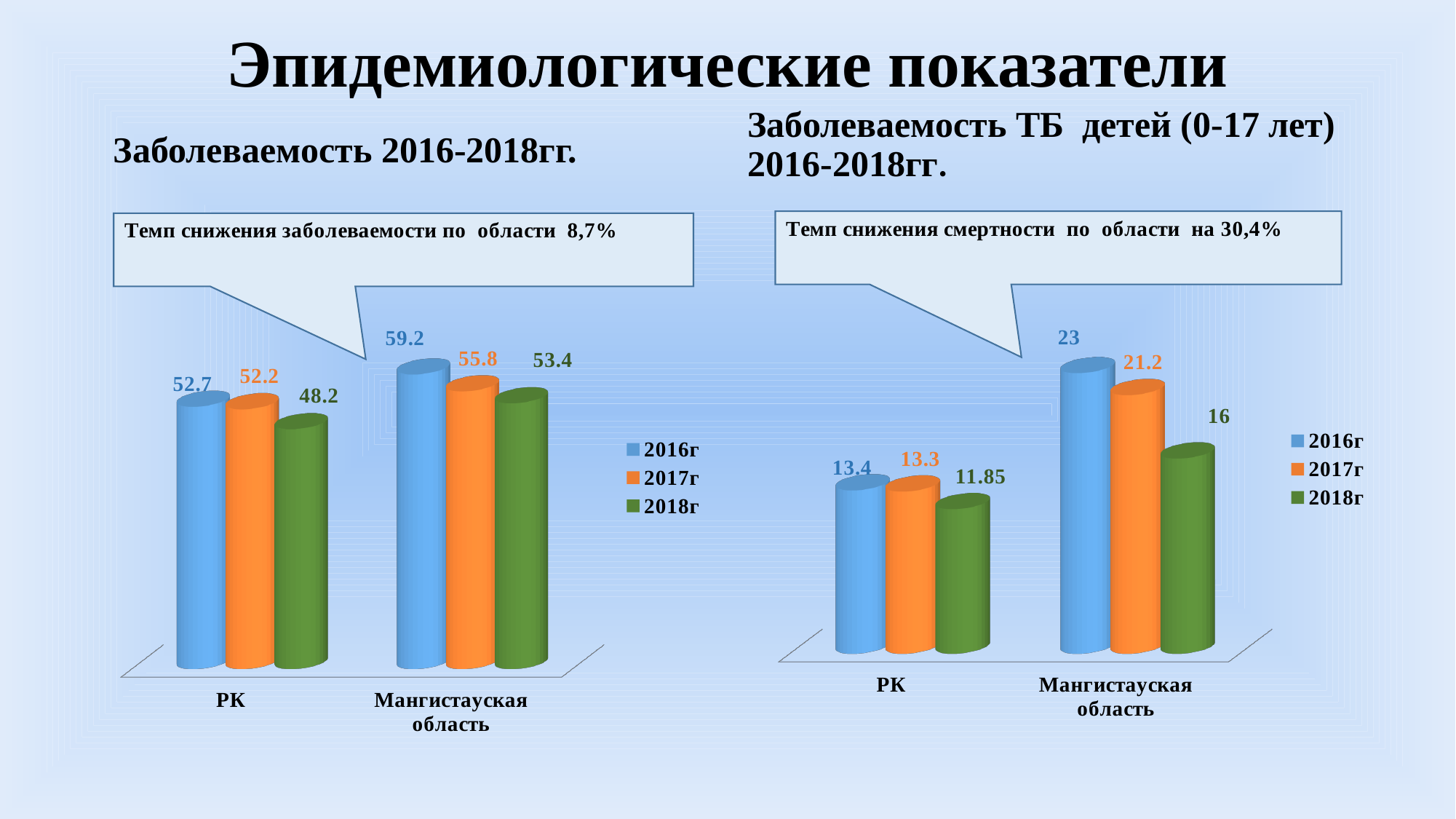
What kind of chart is the right chart (Заболеваемость ТБ детей)? Bar chart How many series does the legend of the left chart (Заболеваемость 2016-2018гг.) list? 3 In the left chart (Заболеваемость 2016-2018гг.), do the values for РК rise or fall from 2016г to 2018г? Fall In the right chart (Заболеваемость ТБ детей), what is the value for РК in 2018г? 11.85 In the right chart (Заболеваемость ТБ детей), which is larger: the 2016г value for РК or the 2018г value for Мангистауская область? 2018г value for Мангистауская область In the right chart (Заболеваемость ТБ детей), what is the value for Мангистауская область in 2017г? 21.2 In the left chart (Заболеваемость 2016-2018гг.), which year has the highest value for Мангистауская область? 2016г In the right chart (Заболеваемость ТБ детей), what is the difference between the 2016г and 2018г values for Мангистауская область? 7 In the left chart (Заболеваемость 2016-2018гг.), what is the value for Мангистауская область in 2016г? 59.2 In the left chart (Заболеваемость 2016-2018гг.), what is the value for РК in 2018г? 48.2 In the left chart (Заболеваемость 2016-2018гг.), what is the difference between the 2016г and 2018г values for Мангистауская область? 5.8 In the right chart (Заболеваемость ТБ детей), which year has the lowest value for Мангистауская область? 2018г